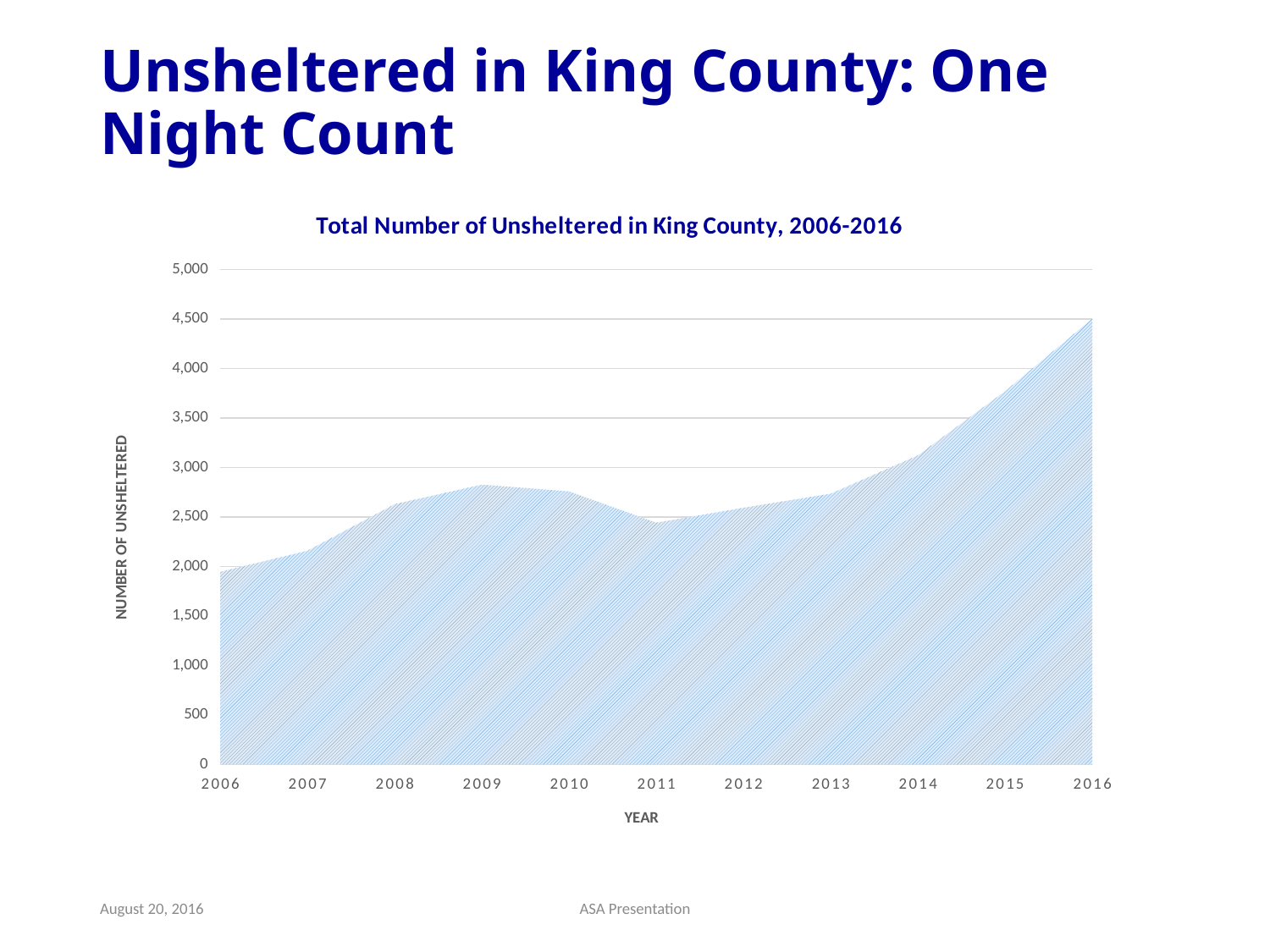
Which year has the highest number of unsheltered? 2016 What kind of chart is shown on the slide? area chart Is the value for 2015 greater or less than 3,500? greater Is the value for 2011 greater or less than 2,500? less Is the value for 2016 greater or less than 4,000? greater Which year has the lowest number of unsheltered? 2006 How many years are plotted along the x axis? 11 What is the title of the chart? Total Number of Unsheltered in King County, 2006-2016 Which year has a larger value, 2009 or 2011? 2009 Do the values rise or fall from 2013 to 2016? rise What is the label of the vertical axis? NUMBER OF UNSHELTERED